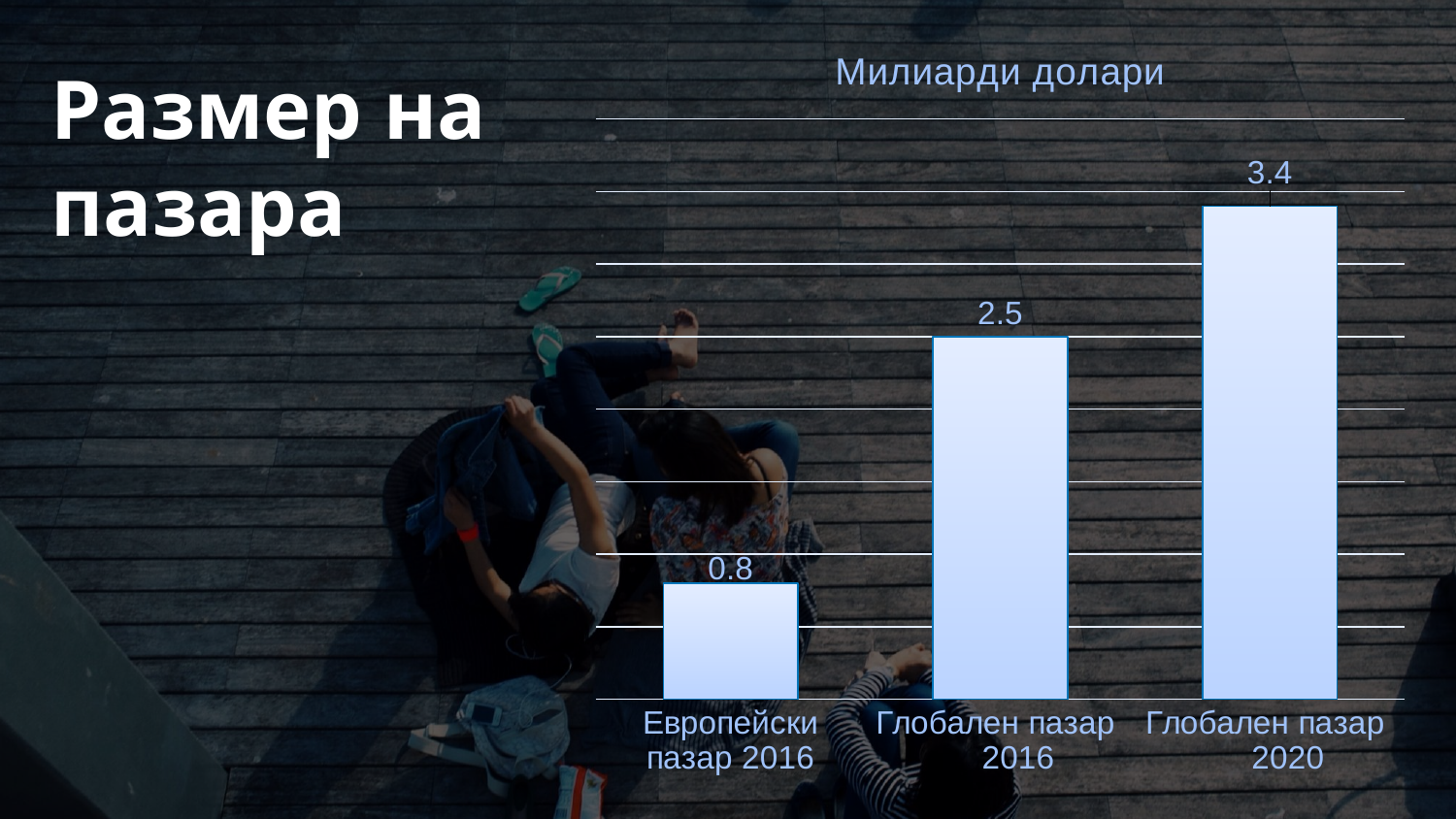
What is the value for Глобален пазар 2016? 2.5 What is the value for Глобален пазар 2020? 3.4 What is the difference between the values for Глобален пазар 2020 and Глобален пазар 2016? 0.9 Which is larger, the value for Глобален пазар 2016 or Европейски пазар 2016? Глобален пазар 2016 How many categories are shown in the chart? 3 Do the values rise or fall from left to right across the categories? Rise What is the title of the chart? Милиарди долари Which category has the highest value? Глобален пазар 2020 What is the difference between the values for Глобален пазар 2016 and Европейски пазар 2016? 1.7 What kind of chart is shown on the slide? Bar chart What is the value for Европейски пазар 2016? 0.8 Which category has the lowest value? Европейски пазар 2016